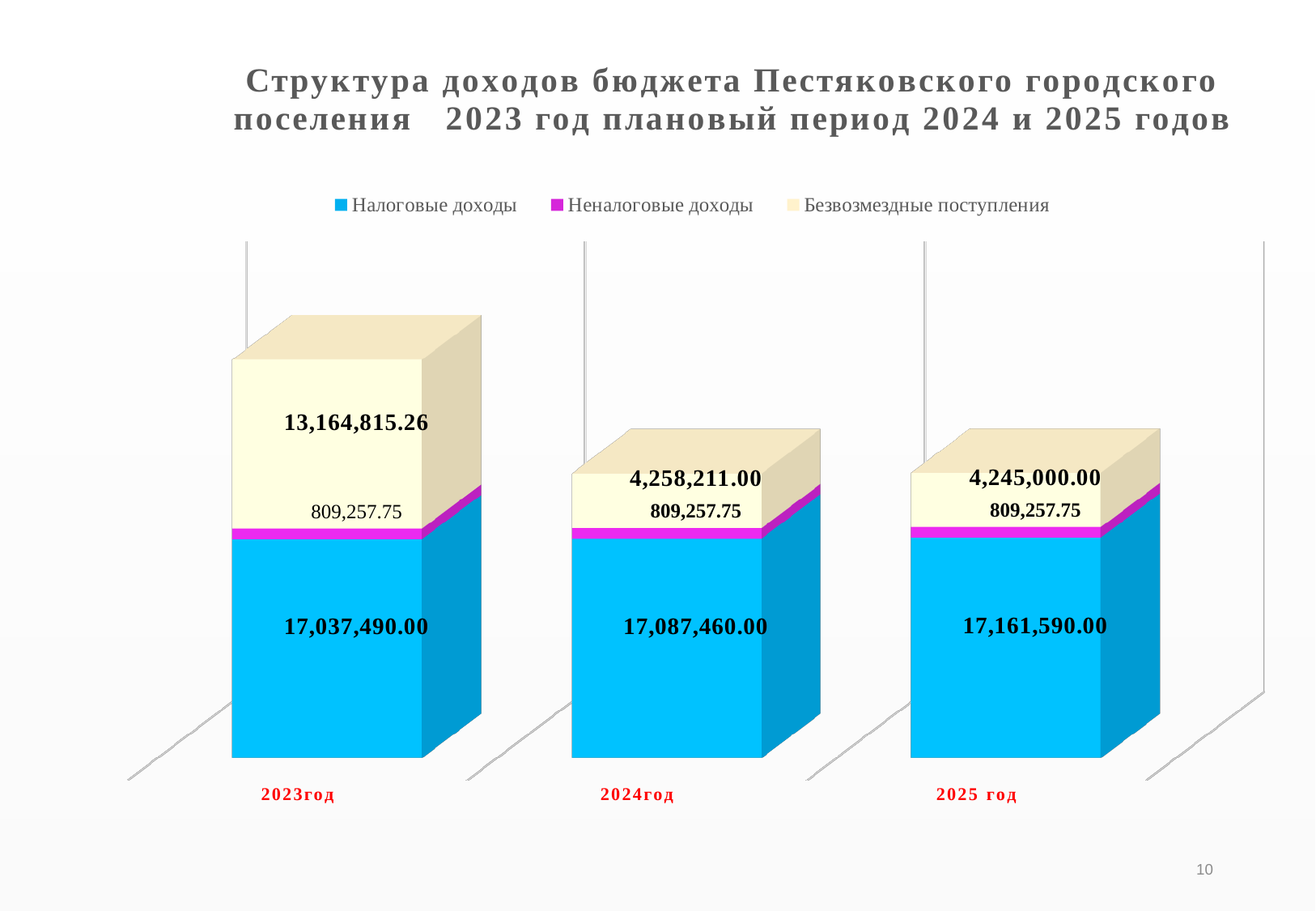
What is the total of the stacked bar for 2024год? 22,154,928.75 In which year is Безвозмездные поступления the highest? 2023год What type of chart is shown on the slide? Stacked bar chart What is the value of Налоговые доходы for 2023год? 17,037,490.00 What is the difference between Безвозмездные поступления in 2023год and 2024год? 8,906,604.26 What is the value of Безвозмездные поступления for 2024год? 4,258,211.00 Which is larger: Налоговые доходы in 2024год or in 2025 год? 2025 год What is the value of Неналоговые доходы for 2025 год? 809,257.75 How many series does the legend list? 3 Which colour represents Неналоговые доходы in the legend? Magenta In which year is Налоговые доходы the lowest? 2023год How many categories (years) are shown on the x axis? 3